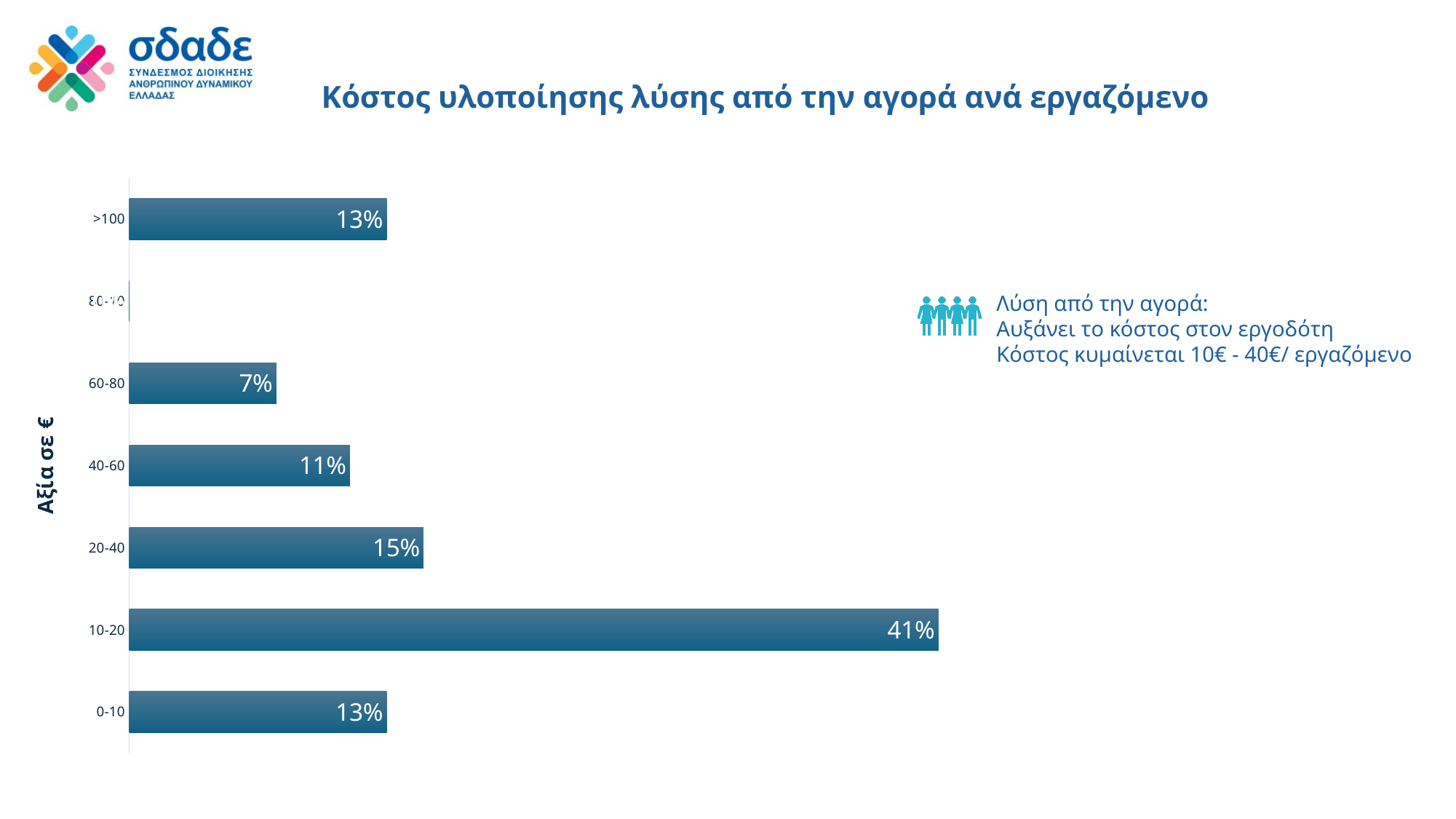
What is the value for the 0-10 category? 13% What is the value for the 10-20 category? 41% What is the label of the vertical axis? Αξία σε € Which category has the highest value? 10-20 What is the value for the 60-80 category? 7% What is the value for the 20-40 category? 15% What is the difference between the values for 0-10 and 60-80? 6% What is the difference between the values for 10-20 and 20-40? 26% Which is larger, the value for 40-60 or the value for 60-80? 40-60 What kind of chart is shown on the slide? Bar chart What is the value for the 40-60 category? 11% What is the value for the >100 category? 13%